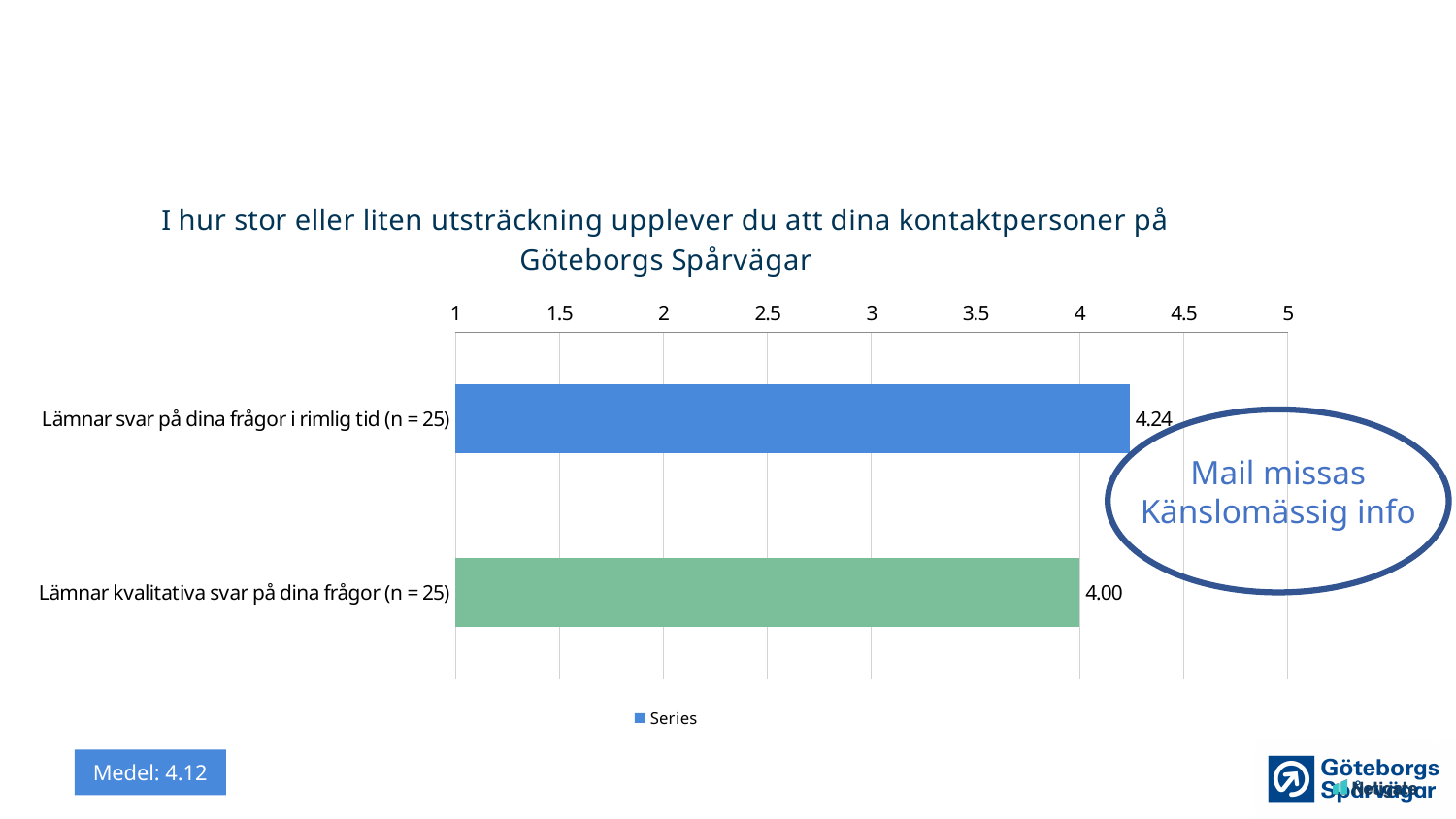
Which category has the highest value? Lämnar svar på dina frågor i rimlig tid (n = 25) How many series does the legend list? 1 Is the value for "Lämnar kvalitativa svar på dina frågor (n = 25)" greater or less than 4.5? less What kind of chart is shown on the slide? Bar chart How many categories are shown in the chart? 2 What is the value for "Lämnar svar på dina frågor i rimlig tid (n = 25)"? 4.24 What is the difference between the values for "Lämnar svar på dina frågor i rimlig tid (n = 25)" and "Lämnar kvalitativa svar på dina frågor (n = 25)"? 0.24 What is the value for "Lämnar kvalitativa svar på dina frågor (n = 25)"? 4.00 Is the value for "Lämnar svar på dina frågor i rimlig tid (n = 25)" greater or less than 4? greater Which is larger: the value for "Lämnar svar på dina frågor i rimlig tid (n = 25)" or for "Lämnar kvalitativa svar på dina frågor (n = 25)"? Lämnar svar på dina frågor i rimlig tid (n = 25) Which category has the lowest value? Lämnar kvalitativa svar på dina frågor (n = 25) What is the maximum value shown on the chart's value axis? 5